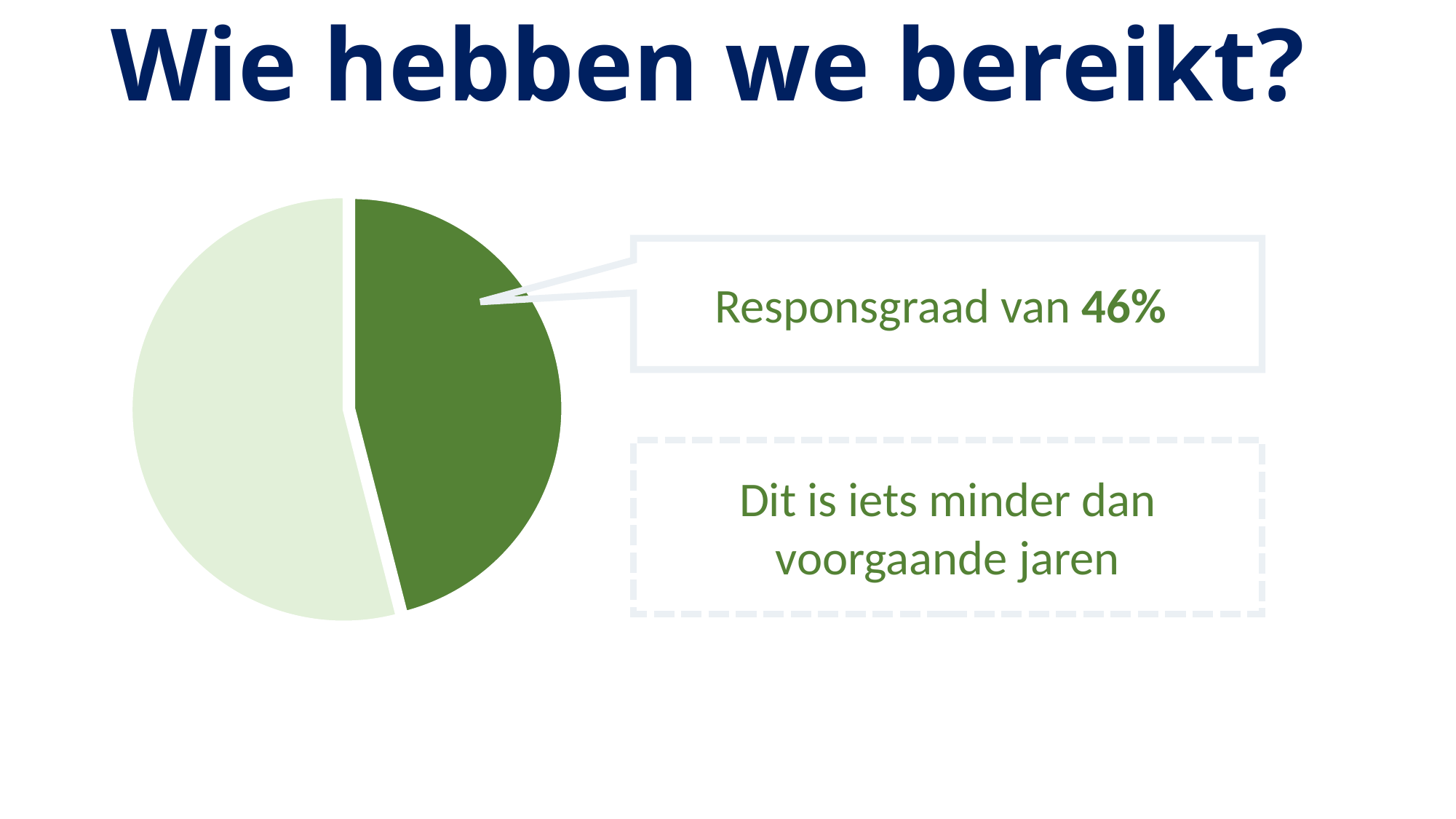
What kind of chart is shown on the slide? pie chart Which slice of the pie chart is the smallest? the dark green slice What is the title of the slide containing the pie chart? Wie hebben we bereikt? How many slices does the pie chart have? 2 What colour is the slice that the 'Responsgraad van 46%' callout points to? dark green What response rate (responsgraad) does the callout on the pie chart give? 46% What share of the pie does the dark green slice represent? 46% Which slice of the pie chart is larger, the dark green slice or the light green slice? the light green slice